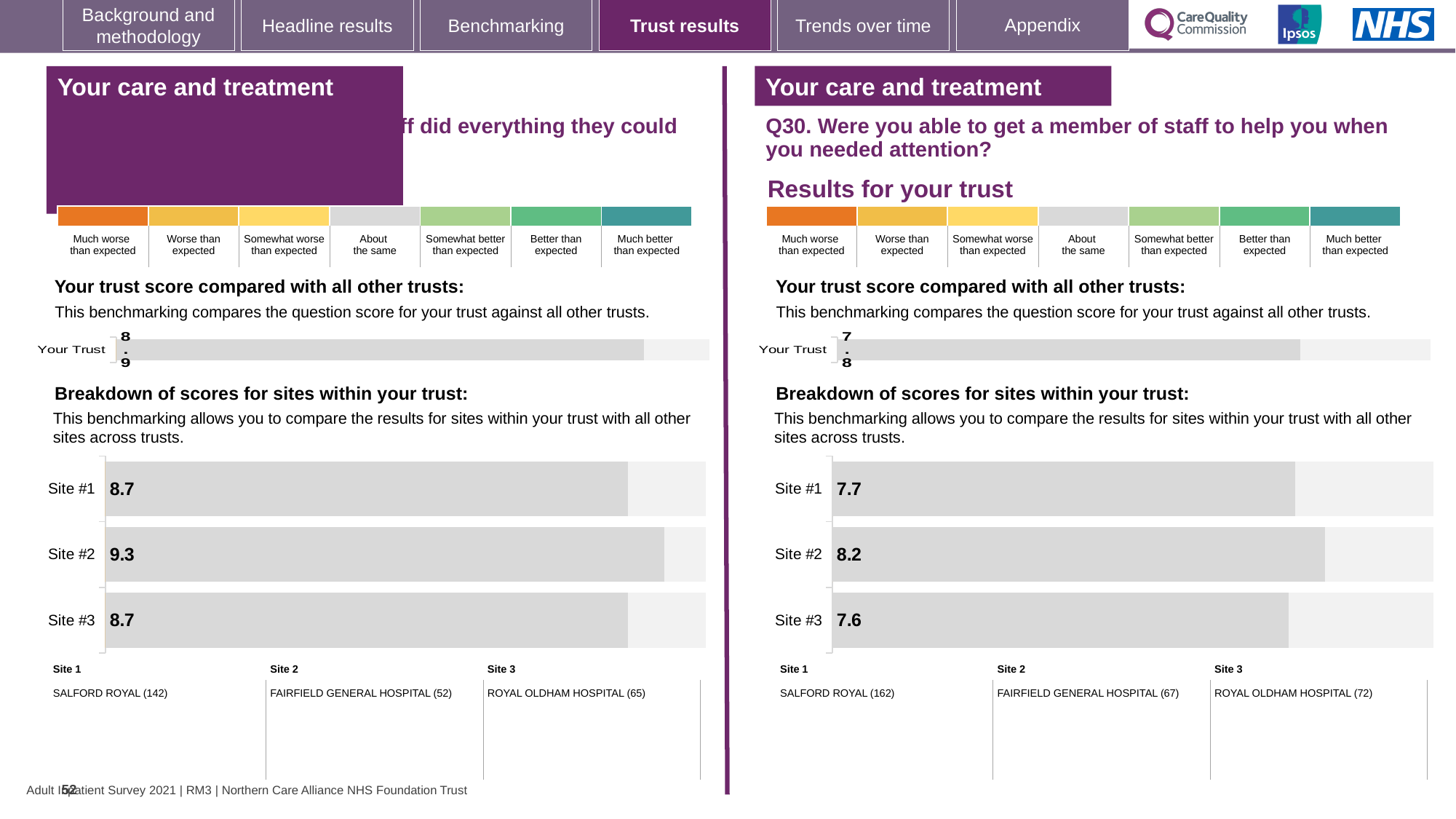
On the left-hand 'Your trust score compared with all other trusts' chart, what is the score for Your Trust? 8.9 Comparing Site #1 on the left-hand site breakdown chart with Site #1 on the Q30 chart on the right, which has the higher score? Left-hand chart (8.7) On the left-hand site breakdown chart, how many sites are shown? 3 On the left-hand site breakdown chart, what is the difference between the scores for Site #2 and Site #1? 0.6 What type of chart is used for the site breakdown on the right-hand side of the slide? Bar chart On the Q30 site breakdown chart on the right, what is the difference between the scores for Site #2 and Site #3? 0.6 On the Q30 site breakdown chart on the right, which site has the highest score? Site #2 On the Q30 site breakdown chart on the right, which site has the lowest score? Site #3 On the left-hand site breakdown chart, what is the score for Site #2? 9.3 On the Q30 site breakdown chart on the right, what is the score for Site #3? 7.6 On the left-hand site breakdown chart, which site has the highest score? Site #2 On the Q30 'Your trust score compared with all other trusts' chart on the right, what is the score for Your Trust? 7.8